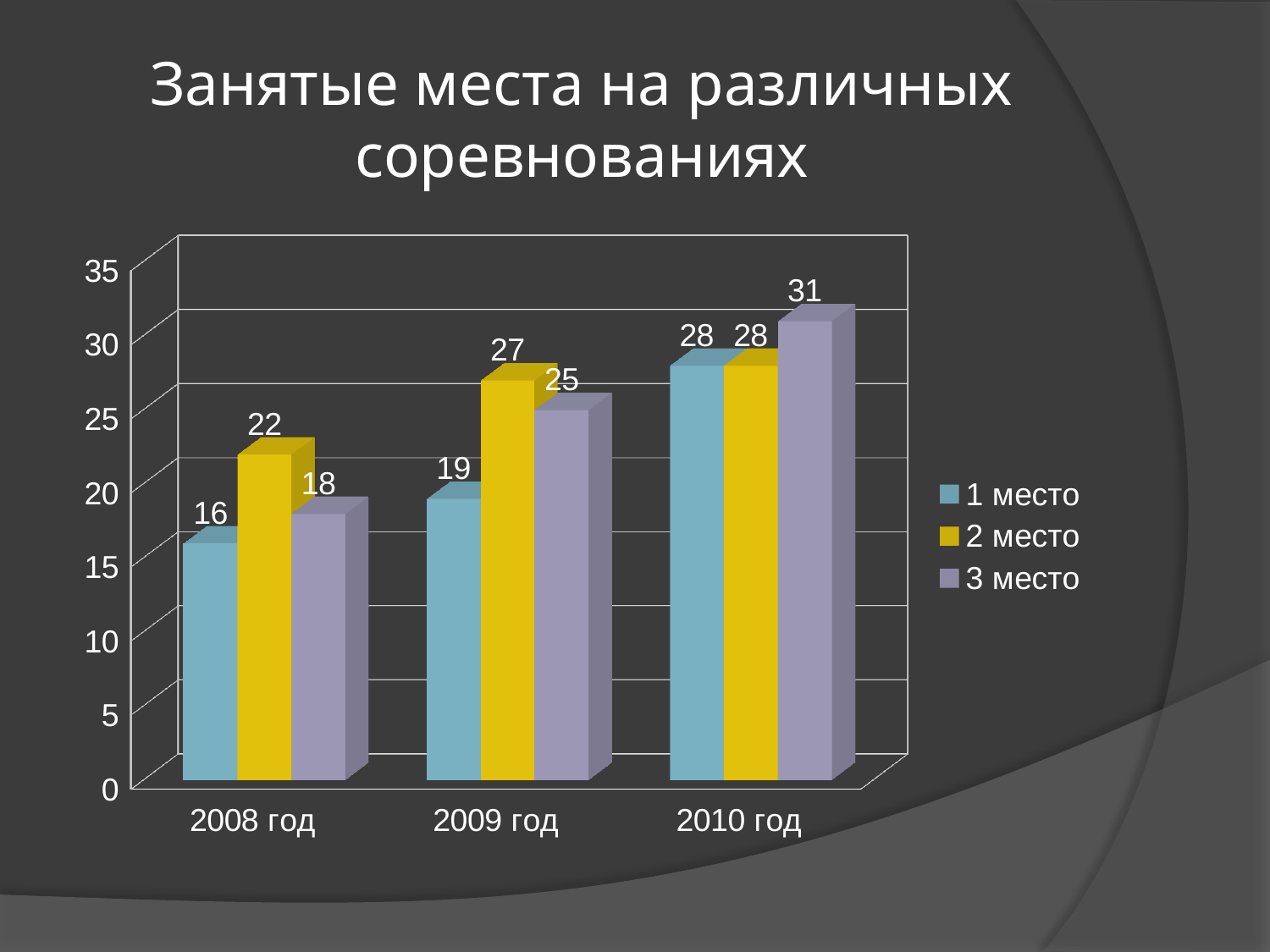
Which year has the highest value for "3 место"? 2010 год Is the value for "3 место" in 2010 год greater or less than 30? greater Do the values for "1 место" rise or fall from 2008 год to 2010 год? rise Which year has the lowest value for "1 место"? 2008 год What is the difference between "2 место" and "1 место" in 2008 год? 6 What is the value for "1 место" in 2008 год? 16 What is the value for "2 место" in 2009 год? 27 How many series does the legend list? 3 How many years are shown on the x axis? 3 What is the value for "3 место" in 2010 год? 31 What kind of chart is shown on the slide? bar chart Which is larger in 2009 год: "2 место" or "3 место"? 2 место